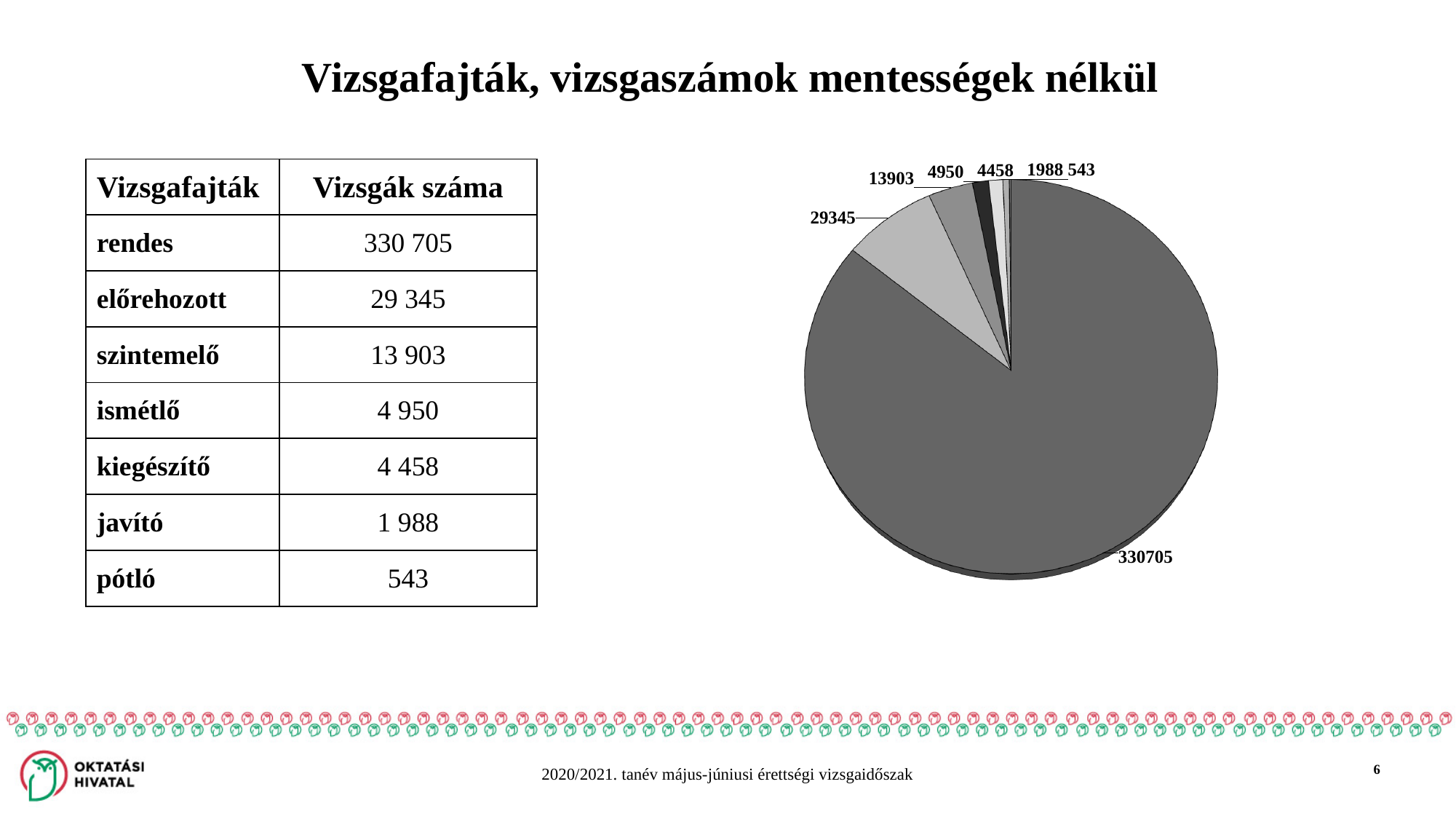
Which exam type (vizsgafajta) does the largest slice of the pie chart represent? rendes What is the difference between the pie slice values 1988 and 543? 1445 Which exam type (vizsgafajta) does the smallest slice of the pie chart represent? pótló What is the value of the smallest slice in the pie chart? 543 What is the value of the largest slice in the pie chart? 330705 Which pie slice is larger: the one labelled 4950 or the one labelled 4458? 4950 What value is labelled on the pie slice for előrehozott exams? 29345 What value is labelled on the pie slice for szintemelő exams? 13903 How many slices does the pie chart have? 7 What is the total of all the values labelled on the pie chart? 385892 What kind of chart is shown on the slide? pie chart What is the difference between the pie slice values 29345 and 13903? 15442